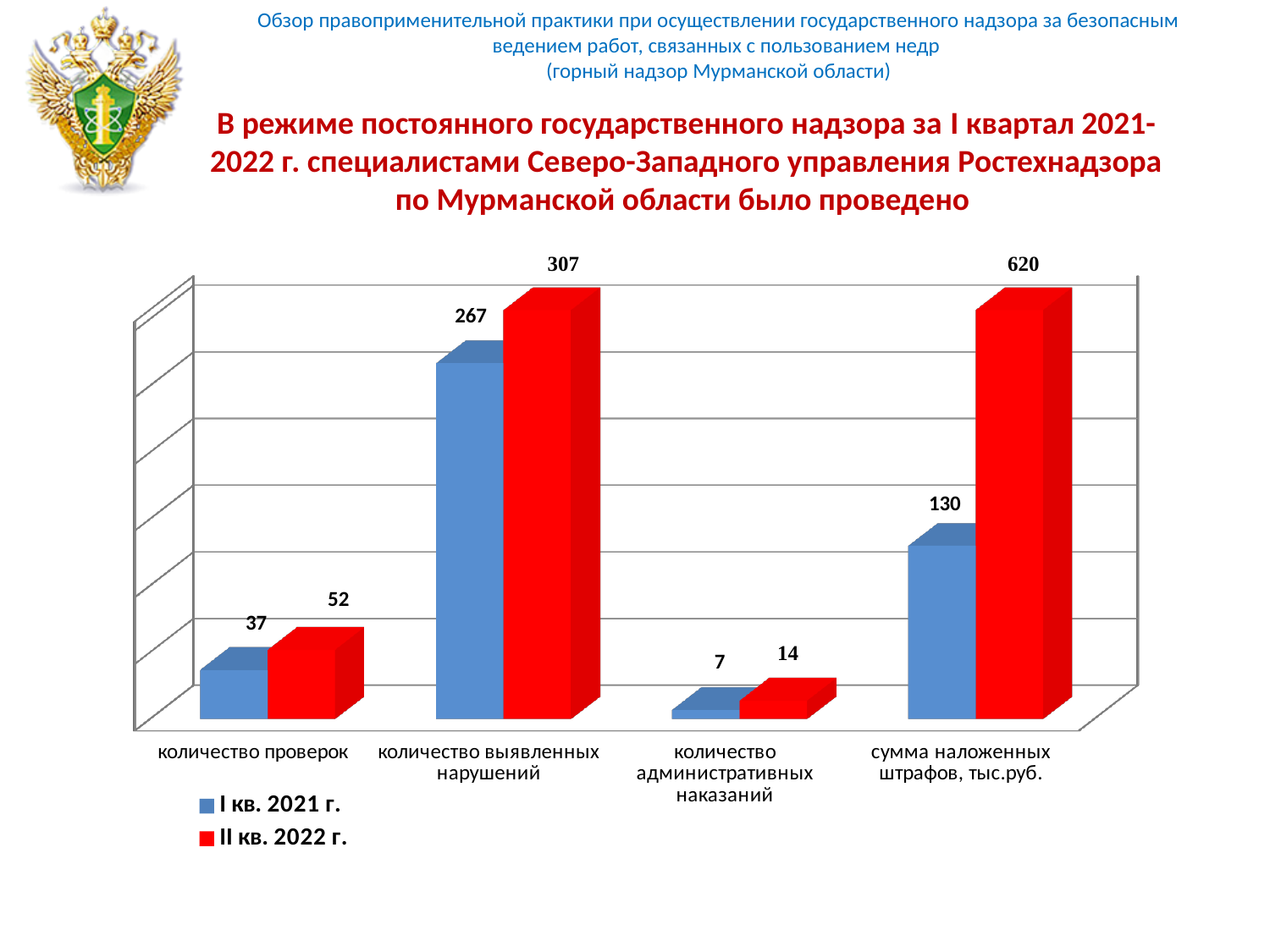
How many series does the chart legend list? 2 What is the value for "количество административных наказаний" in the "I кв. 2021 г." series? 7 Which category has the highest value in the "II кв. 2022 г." series? сумма наложенных штрафов, тыс.руб. What is the value for "количество выявленных нарушений" in the "II кв. 2022 г." series? 307 Which is larger for "количество проверок": the "I кв. 2021 г." value or the "II кв. 2022 г." value? II кв. 2022 г. What kind of chart is shown on the slide? bar chart What is the value for "сумма наложенных штрафов, тыс.руб." in the "II кв. 2022 г." series? 620 Which category has the lowest value in the "I кв. 2021 г." series? количество административных наказаний How many categories are shown on the x axis of the chart? 4 What is the difference between the "II кв. 2022 г." and "I кв. 2021 г." values for "сумма наложенных штрафов, тыс.руб."? 490 What is the difference between the "II кв. 2022 г." and "I кв. 2021 г." values for "количество выявленных нарушений"? 40 What is the value for "количество проверок" in the "I кв. 2021 г." series? 37